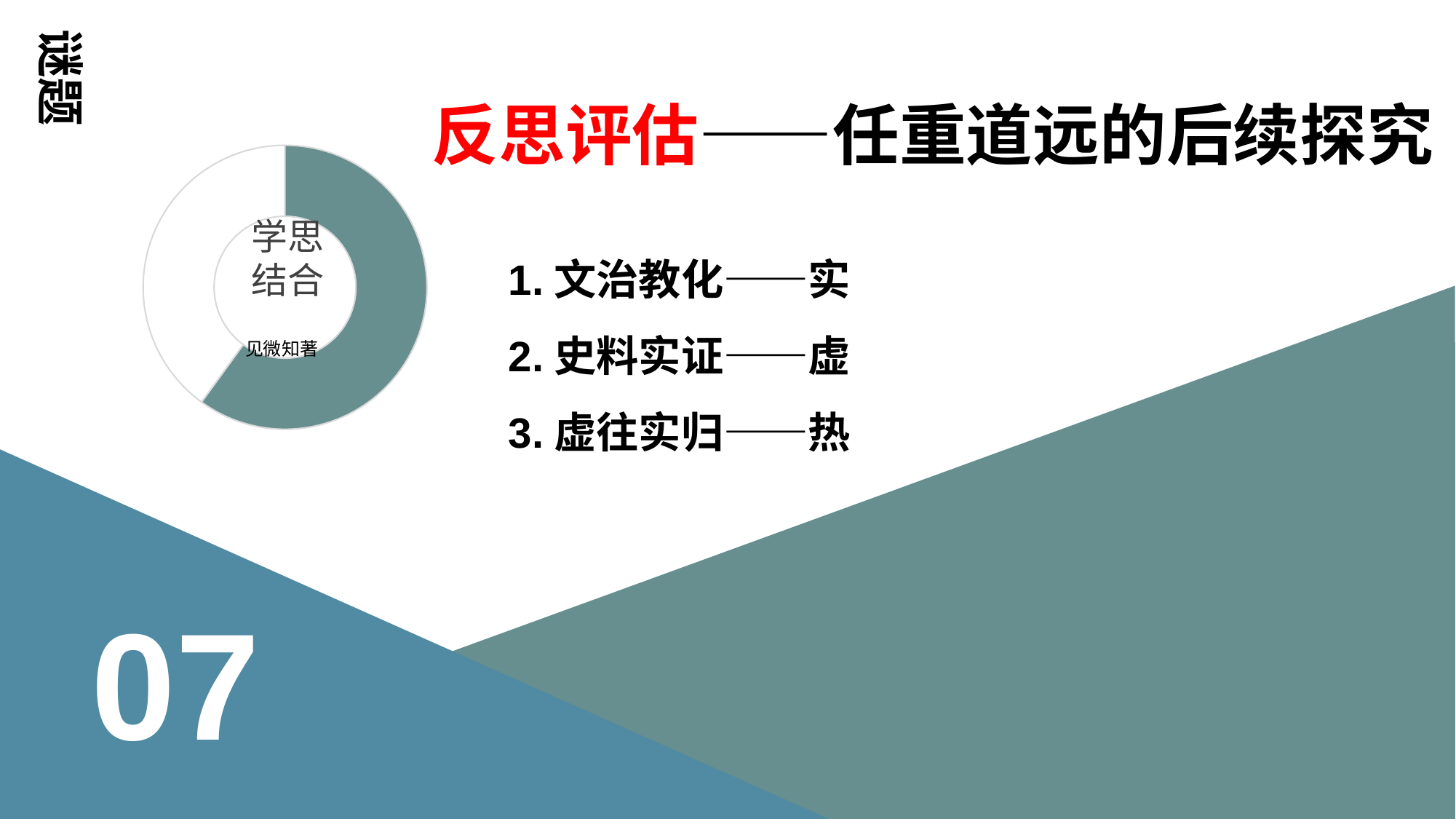
What text appears in the centre of the doughnut chart on the left of the slide? 学思结合 见微知著 What kind of chart is shown on the left of the slide? doughnut chart In the doughnut chart on the left of the slide, which slice is larger, the teal one or the white one? the teal one Does the doughnut chart on the left of the slide show a legend? No How many slices does the doughnut chart on the left of the slide have? 2 In the doughnut chart on the left of the slide, is the teal slice greater or less than half of the ring? greater